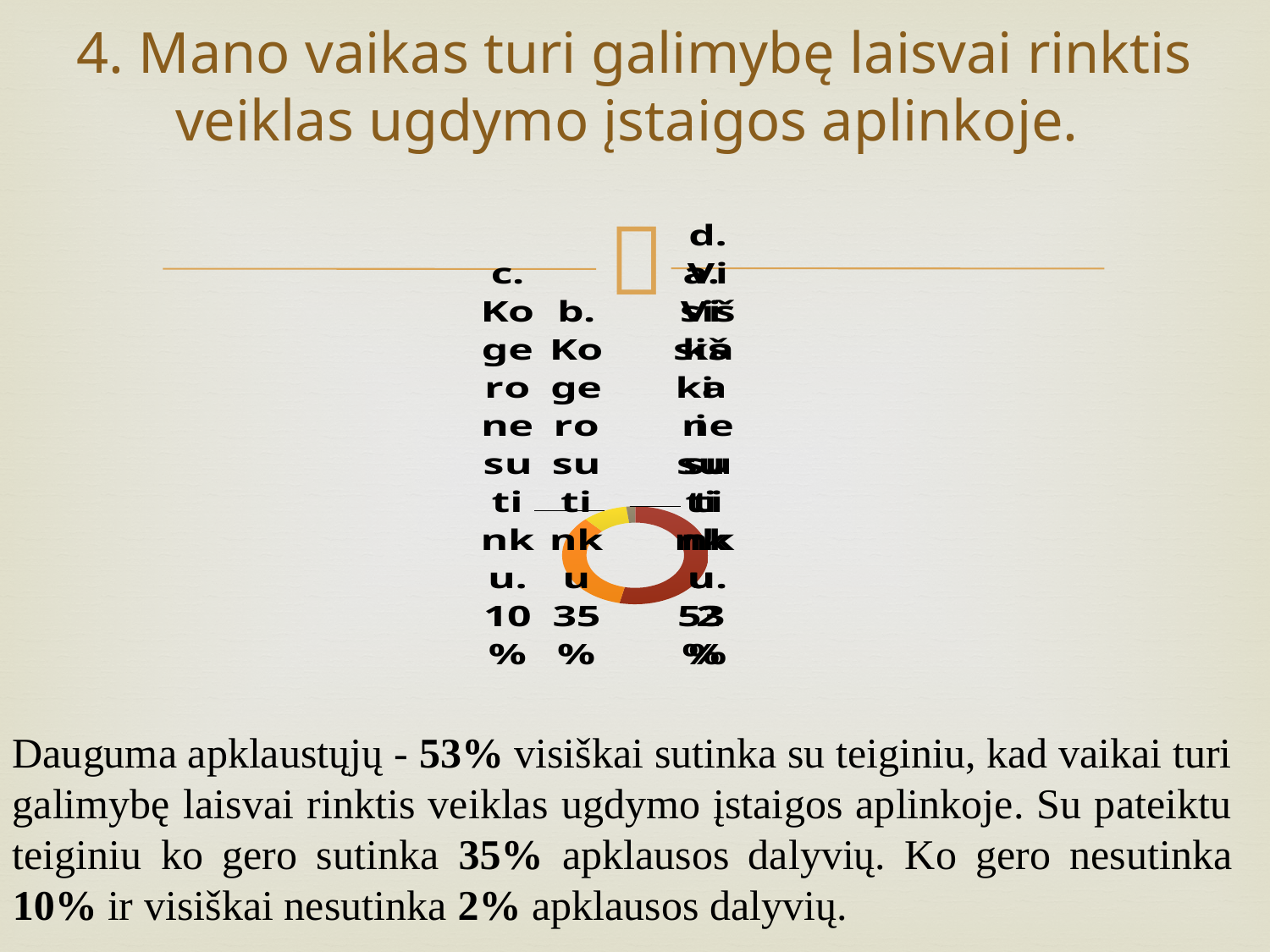
Which response category has the smallest share of the chart? Visiškai nesutinku (2%) Which response category has the largest share of the chart? Visiškai sutinku (53%) What kind of chart is shown on the slide? Doughnut (pie) chart What percentage of respondents chose "Visiškai nesutinku" (d)? 2% What percentage of respondents chose "Ko gero nesutinku" (c)? 10% What percentage of respondents chose "Visiškai sutinku" (a)? 53% What is the difference in percentage points between "Ko gero nesutinku" and "Visiškai nesutinku"? 8 percentage points What percentage of respondents chose "Ko gero sutinku" (b)? 35% How many response categories are shown in the chart? 4 What is the combined share of respondents who agree ("Visiškai sutinku" plus "Ko gero sutinku")? 88% What is the difference in percentage points between "Visiškai sutinku" and "Ko gero sutinku"? 18 percentage points Which is larger: the share for "Ko gero sutinku" or the share for "Ko gero nesutinku"? Ko gero sutinku